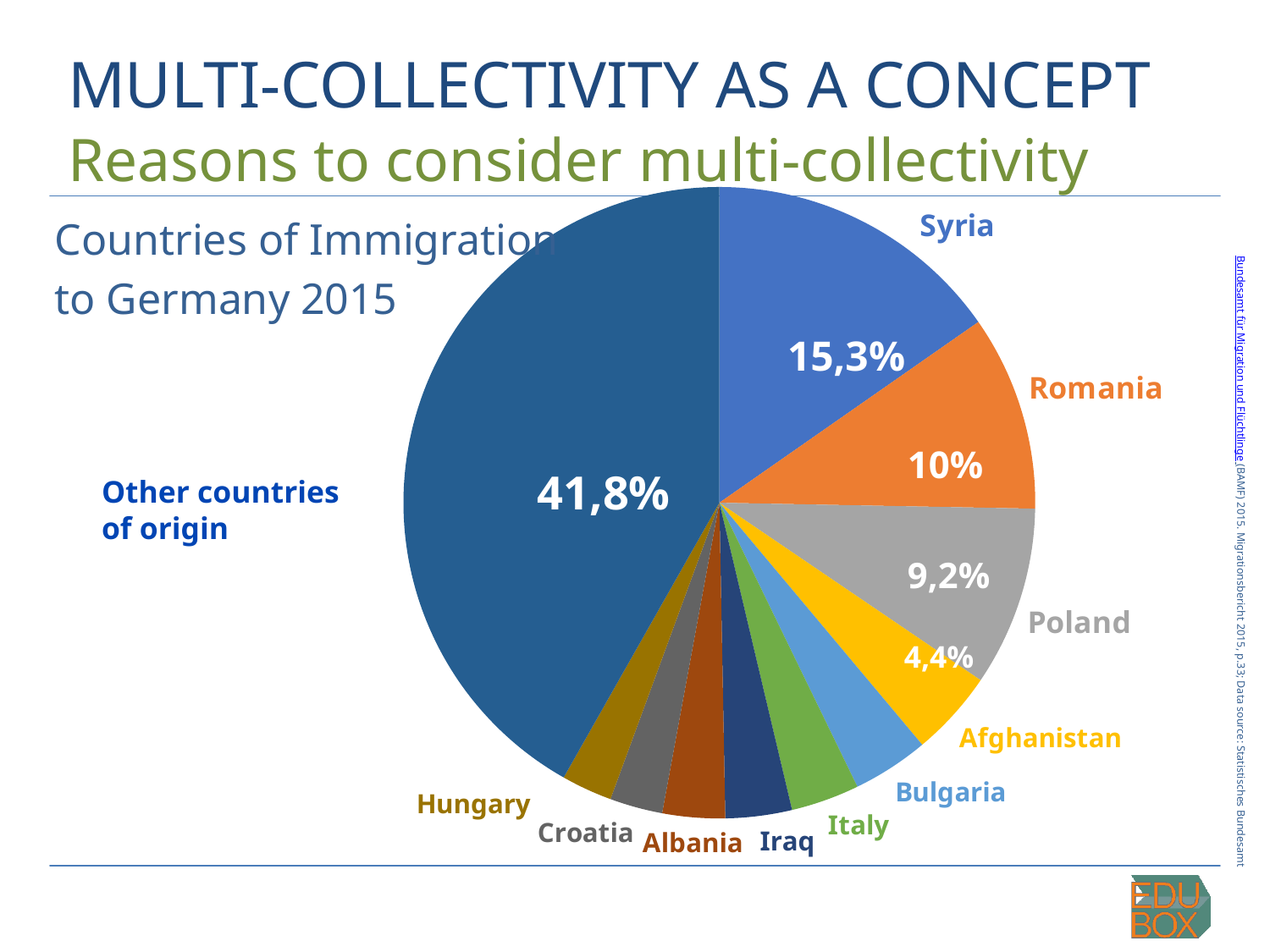
How many slices does the pie chart have? 11 What percentage is shown for Afghanistan? 4,4% What share of the pie is labelled for Romania? 10% What percentage is shown for Poland? 9,2% What is the title of the pie chart? Countries of Immigration to Germany 2015 By how many percentage points does Romania's share exceed Poland's? 0,8 percentage points Which has the larger share, Syria or Romania? Syria Which slice of the pie is the largest? Other countries of origin By how many percentage points does Syria's share exceed Romania's? 5,3 percentage points What share of the pie is taken by 'Other countries of origin'? 41,8% What kind of chart is shown on the slide? pie chart What share of immigration to Germany in 2015 came from Syria? 15,3%